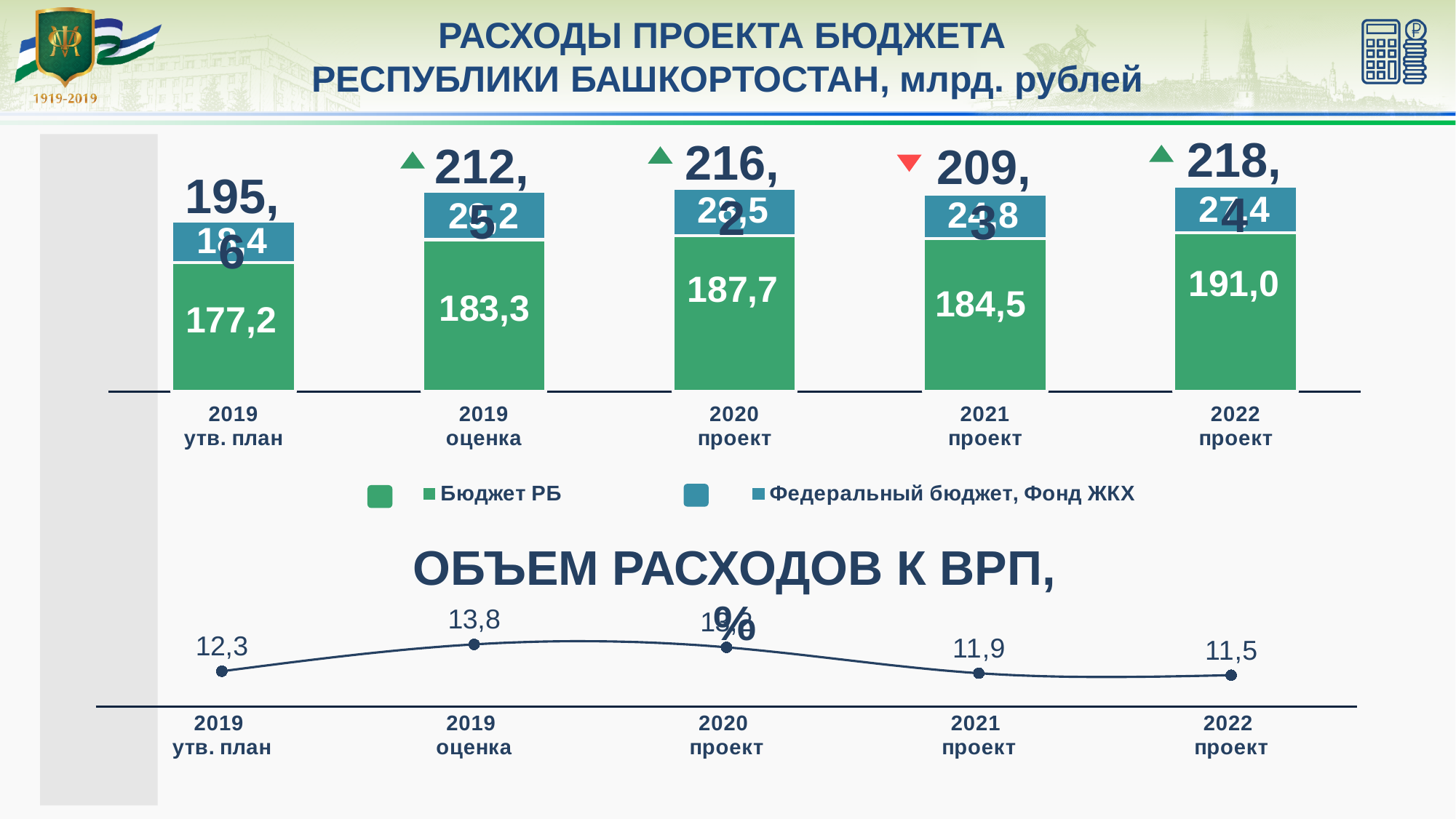
In the top bar chart, what is the value of 'Бюджет РБ' for '2022 проект'? 191,0 In the top bar chart, what is the value of 'Бюджет РБ' for '2020 проект'? 187,7 In the bottom line chart 'ОБЪЕМ РАСХОДОВ К ВРП, %', which is larger: the value for '2021 проект' or '2022 проект'? 2021 проект In the top bar chart, which category has the lowest value for 'Бюджет РБ'? 2019 утв. план In the top bar chart, what is the total of the stacked bar for '2019 утв. план'? 195,6 What kind of chart is the top chart titled 'РАСХОДЫ ПРОЕКТА БЮДЖЕТА РЕСПУБЛИКИ БАШКОРТОСТАН'? bar chart In the top bar chart, which category has the highest total? 2022 проект How many series does the legend of the top bar chart list? 2 How many categories are shown on the x axis of the top bar chart? 5 In the bottom line chart 'ОБЪЕМ РАСХОДОВ К ВРП, %', which category has the lowest value? 2022 проект In the top bar chart, what is the difference between the 'Бюджет РБ' values for '2022 проект' and '2019 утв. план'? 13,8 In the bottom line chart 'ОБЪЕМ РАСХОДОВ К ВРП, %', what is the value for '2019 оценка'? 13,8